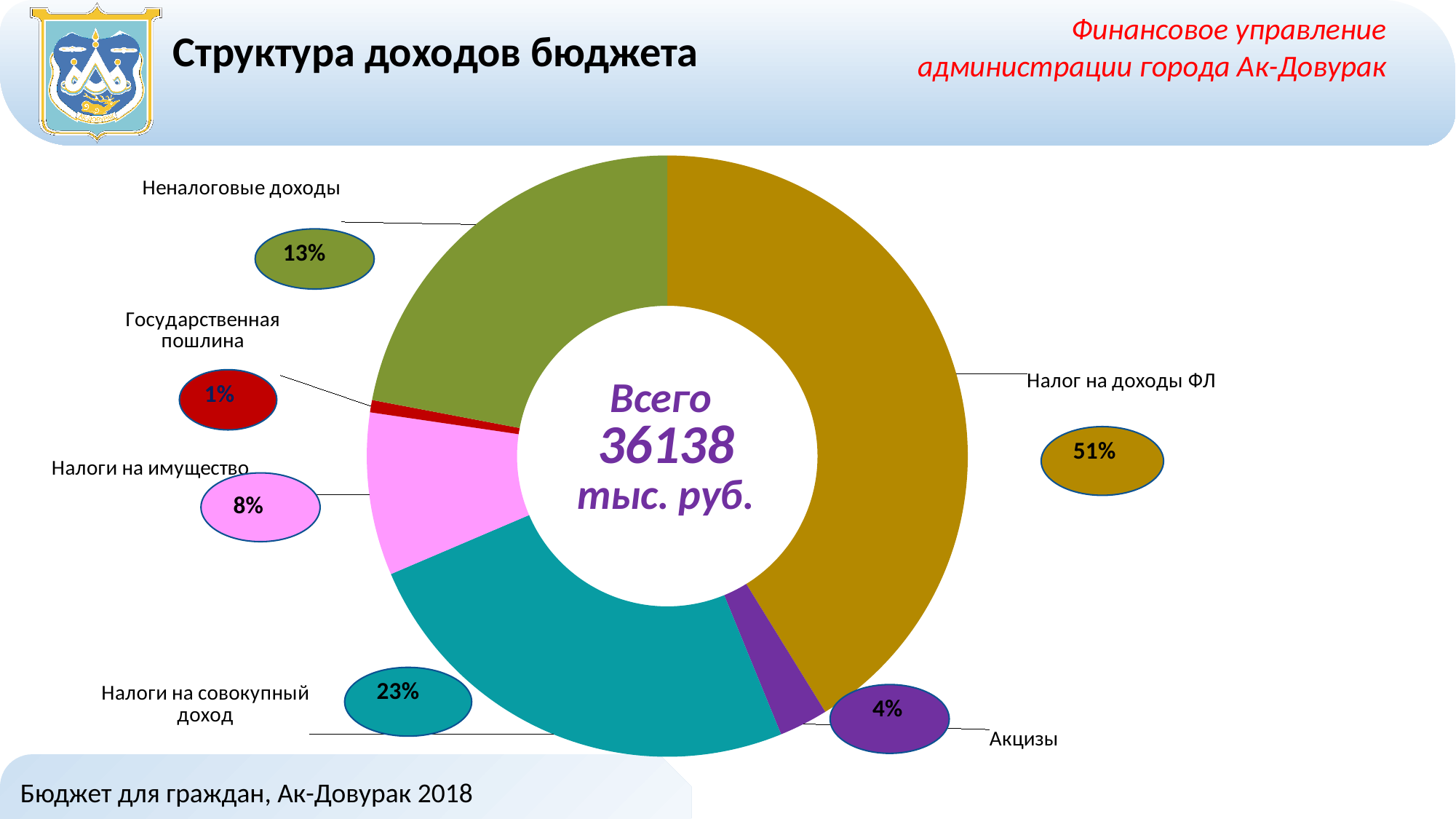
What type of chart is shown on the slide? Doughnut (pie) chart What colour is the segment for Налоги на совокупный доход? Teal What share of budget revenue comes from Налоги на совокупный доход? 23% Which revenue category has the smallest share of the budget? Государственная пошлина What share of budget revenue comes from Акцизы? 4% What share of budget revenue comes from Налог на доходы ФЛ? 51% What total value is shown in the centre of the chart? 36138 тыс. руб. What is the difference in percentage points between Налог на доходы ФЛ and Налоги на совокупный доход? 28 Which has a larger share: Налоги на имущество or Неналоговые доходы? Неналоговые доходы How many revenue categories are shown in the chart? 6 Which revenue category has the largest share of the budget? Налог на доходы ФЛ What share of budget revenue comes from Неналоговые доходы? 13%